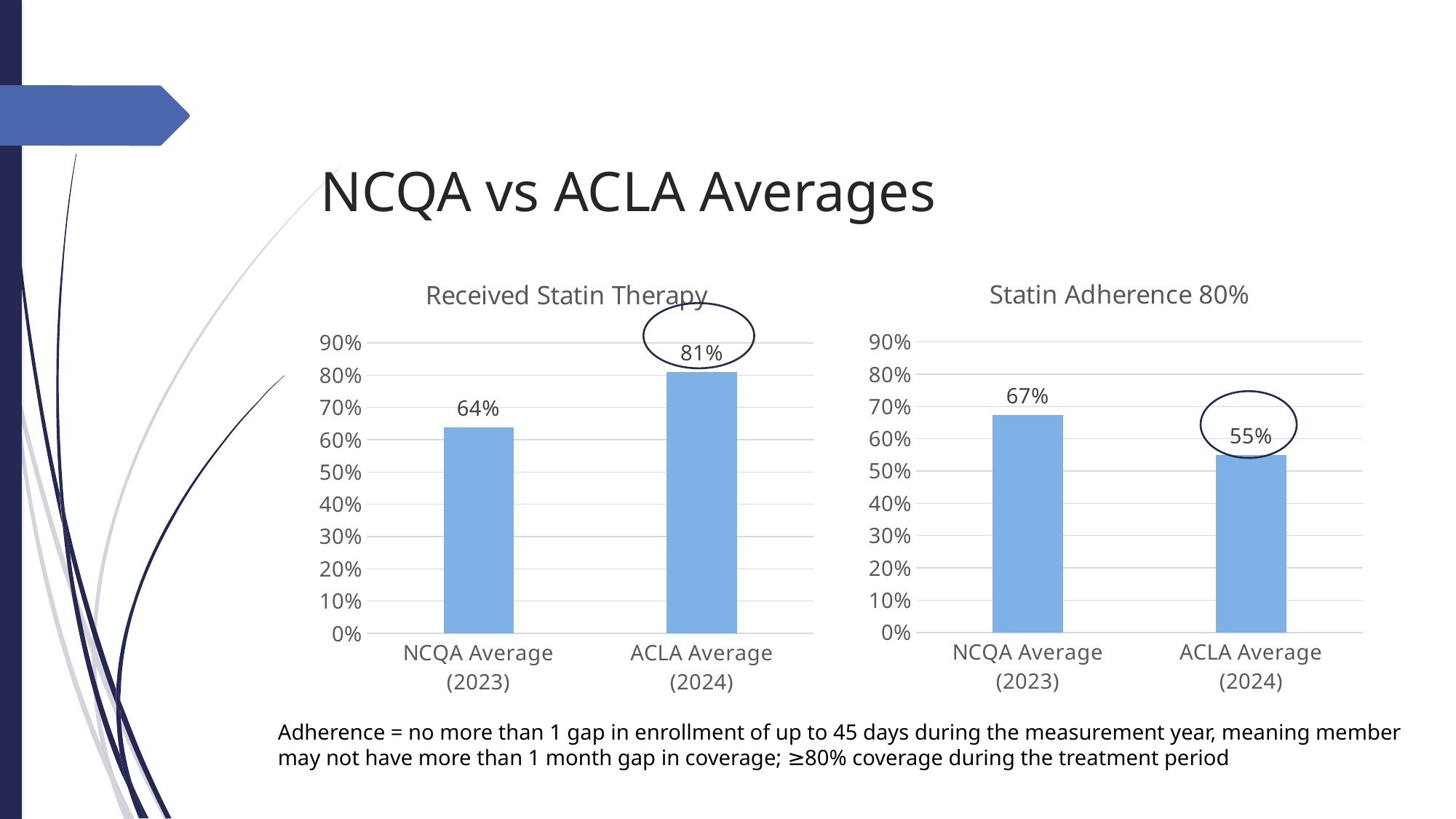
In the 'Received Statin Therapy' chart, what is the value for ACLA Average (2024)? 81% In the 'Statin Adherence 80%' chart, what is the difference between the NCQA Average (2023) and the ACLA Average (2024)? 12% In the 'Statin Adherence 80%' chart, which category has the lowest value? ACLA Average (2024) In the 'Received Statin Therapy' chart, which category has the highest value? ACLA Average (2024) How many categories are shown in the 'Statin Adherence 80%' chart? 2 In the 'Statin Adherence 80%' chart, what is the value for NCQA Average (2023)? 67% In the 'Statin Adherence 80%' chart, which is larger: NCQA Average (2023) or ACLA Average (2024)? NCQA Average (2023) In the 'Received Statin Therapy' chart, what is the value for NCQA Average (2023)? 64% What type of chart is the 'Received Statin Therapy' chart? Bar chart In the 'Statin Adherence 80%' chart, what is the value for ACLA Average (2024)? 55% In the 'Received Statin Therapy' chart, is the value for ACLA Average (2024) greater or less than 80%? greater In the 'Received Statin Therapy' chart, what is the difference between the ACLA Average (2024) and the NCQA Average (2023)? 17%